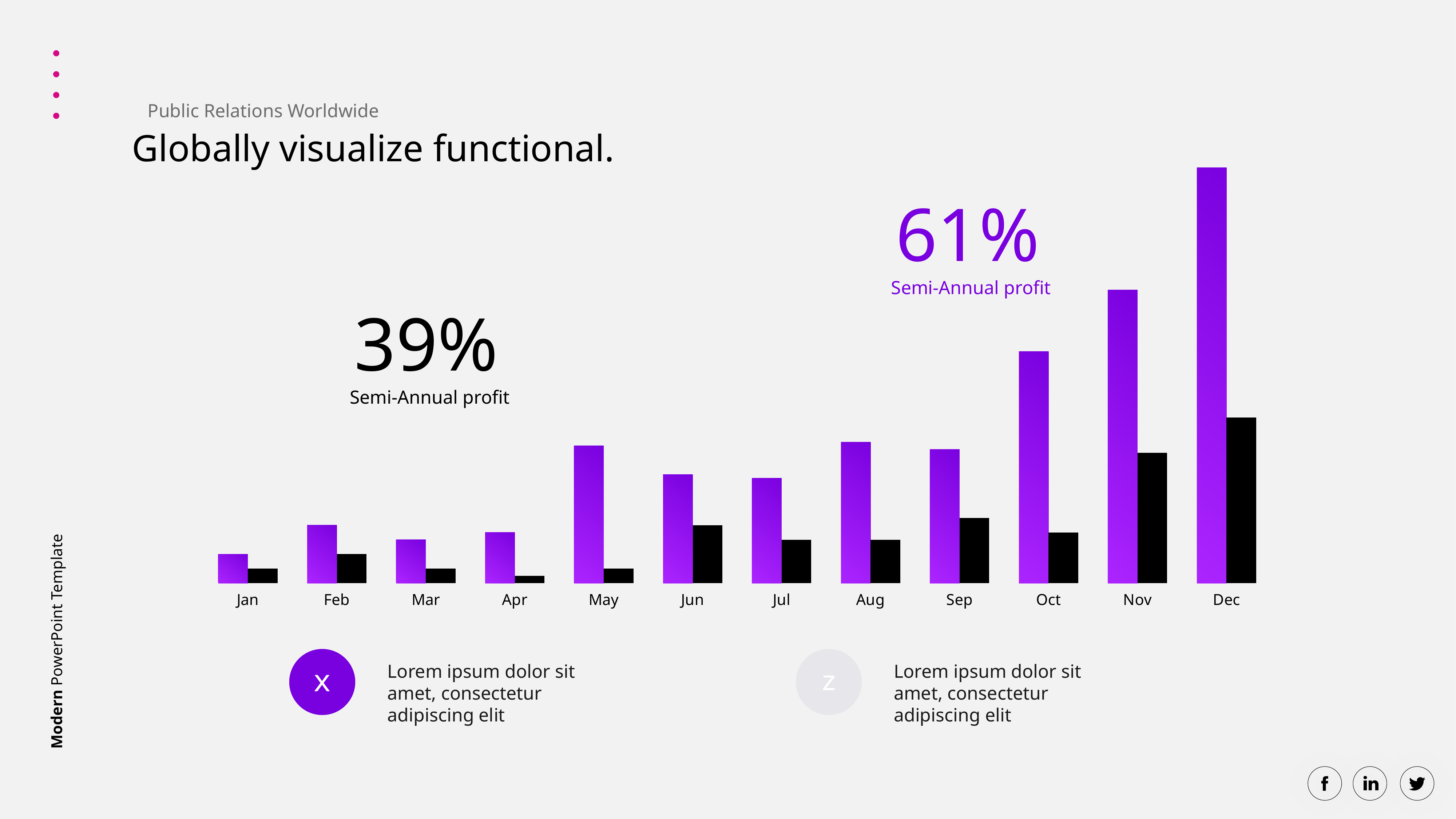
Is the purple bar for May taller or shorter than the purple bar for Jun? taller Which month has the taller black bar, Feb or Jan? Feb Which month has the shortest purple bar? Jan Which month has the tallest purple bar? Dec How many months are shown along the x axis of the chart? 12 Which month has the taller purple bar, Nov or Oct? Nov Do the purple bars generally rise or fall from Jan to Dec? rise How many series of bars does the chart plot for each month? 2 What kind of chart is shown on the slide? bar chart Which month has the tallest black bar? Dec Which month has the shortest black bar? Apr What two colours are used for the bars in the chart? purple and black